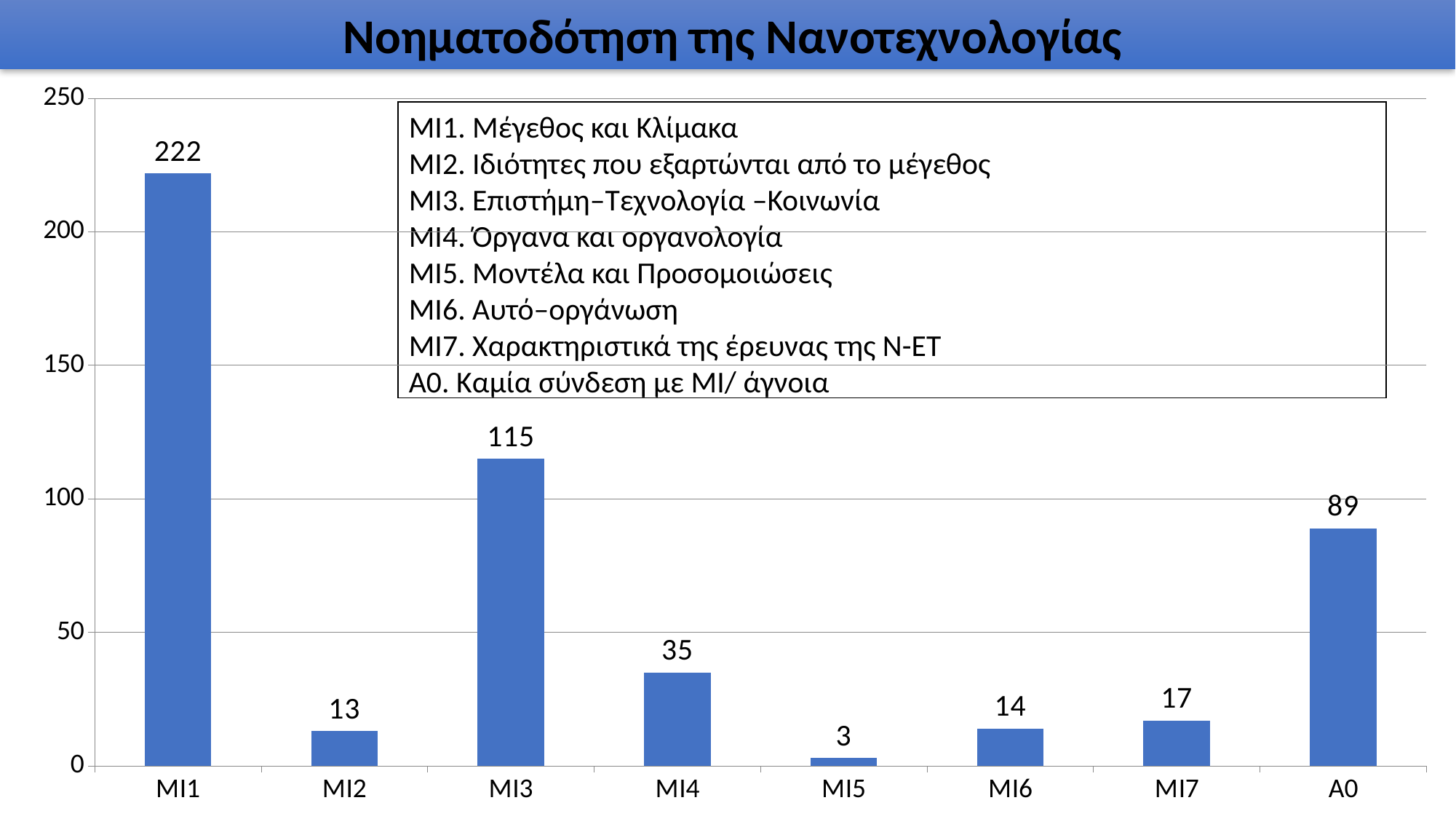
What is the value for MI5? 3 Which category has the lowest value? MI5 What is the difference between the values for MI1 and MI3? 107 What is the difference between the values for MI7 and MI6? 3 Which category has the highest value? MI1 How many categories are shown on the x axis? 8 What is the value for MI3? 115 What is the title of the chart? Νοηματοδότηση της Νανοτεχνολογίας What kind of chart is shown on the slide? Bar chart Which is larger, the value for MI4 or the value for MI2? MI4 What is the value for MI1? 222 What is the value for A0? 89